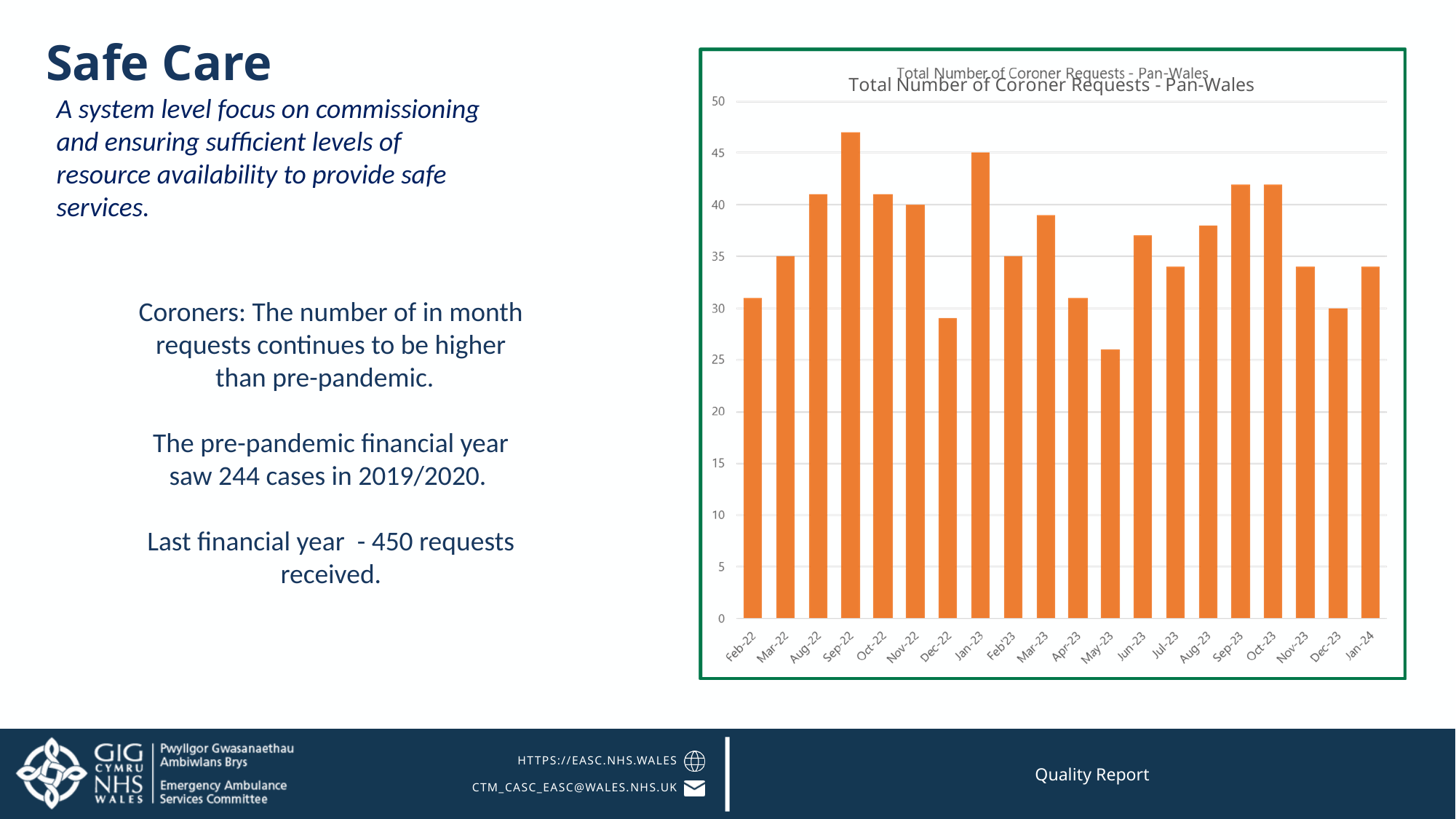
Is the value for Sep-22 greater or less than 45? greater How many months (bars) are plotted in the chart? 20 What is the title of the chart? Total Number of Coroner Requests - Pan-Wales What is the number of coroner requests for Nov-22? 40 Which month has more coroner requests, Jan-23 or Mar-23? Jan-23 Is the value for Sep-23 greater or less than 40? greater Which month has the highest number of coroner requests? Sep-22 Which month has the lowest number of coroner requests? May-23 What colour are the bars in the chart? orange What is the number of coroner requests for Jan-23? 45 Is the value for May-23 greater or less than 30? less What type of chart is shown on the slide? bar chart